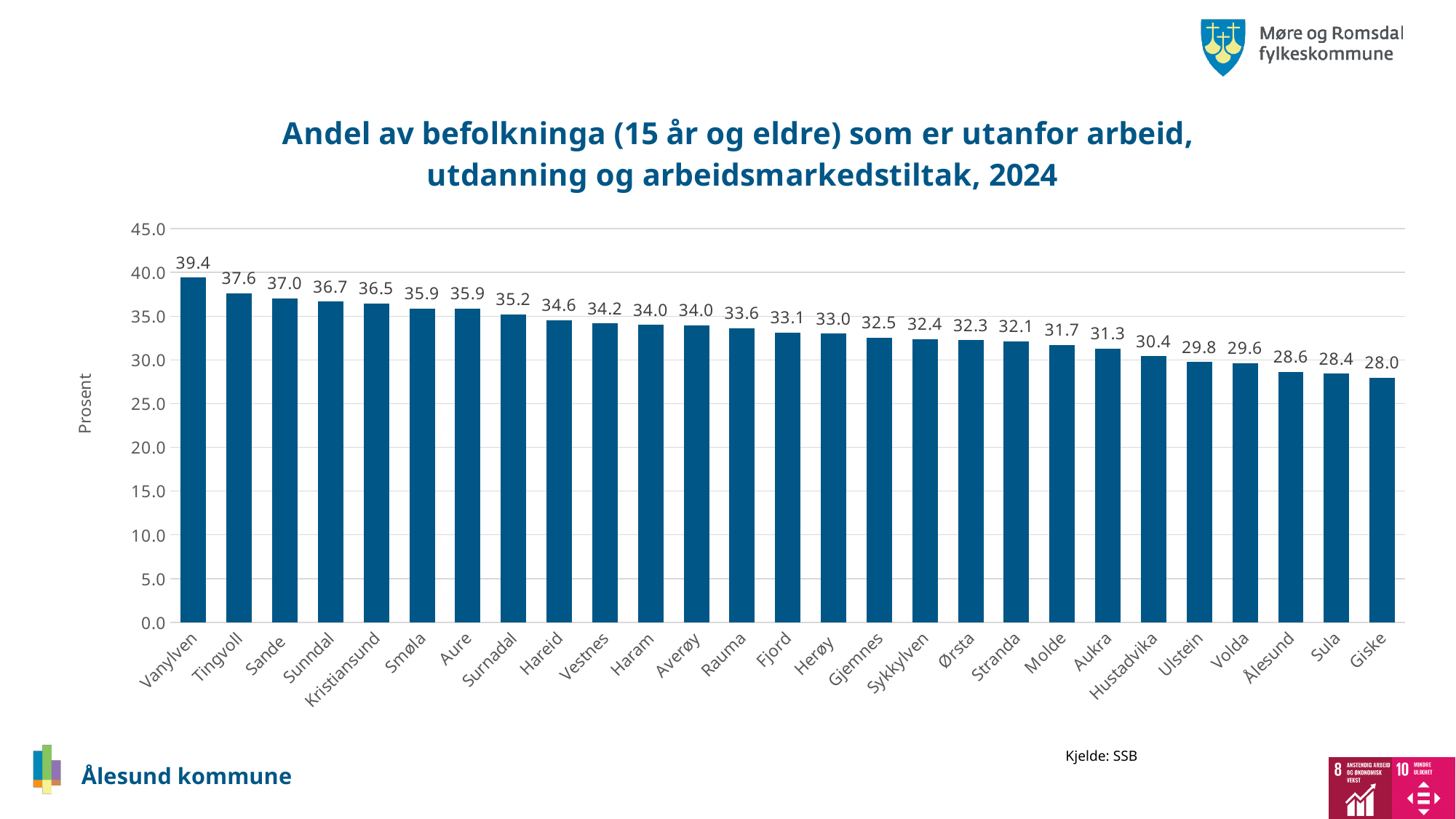
What is the label on the vertical axis? Prosent What is the value for Vanylven? 39.4 What is the value for Ålesund? 28.6 What kind of chart is shown on the slide? Bar chart Is the value for Sula greater or less than 30.0? less What is the value for Molde? 31.7 What is the difference between the values for Vanylven and Giske? 11.4 Which has a higher value, Hareid or Ulstein? Hareid How many municipalities are shown in the chart? 27 Which municipality has the lowest value? Giske Which municipality has the highest value? Vanylven What is the difference between the values for Kristiansund and Molde? 4.8